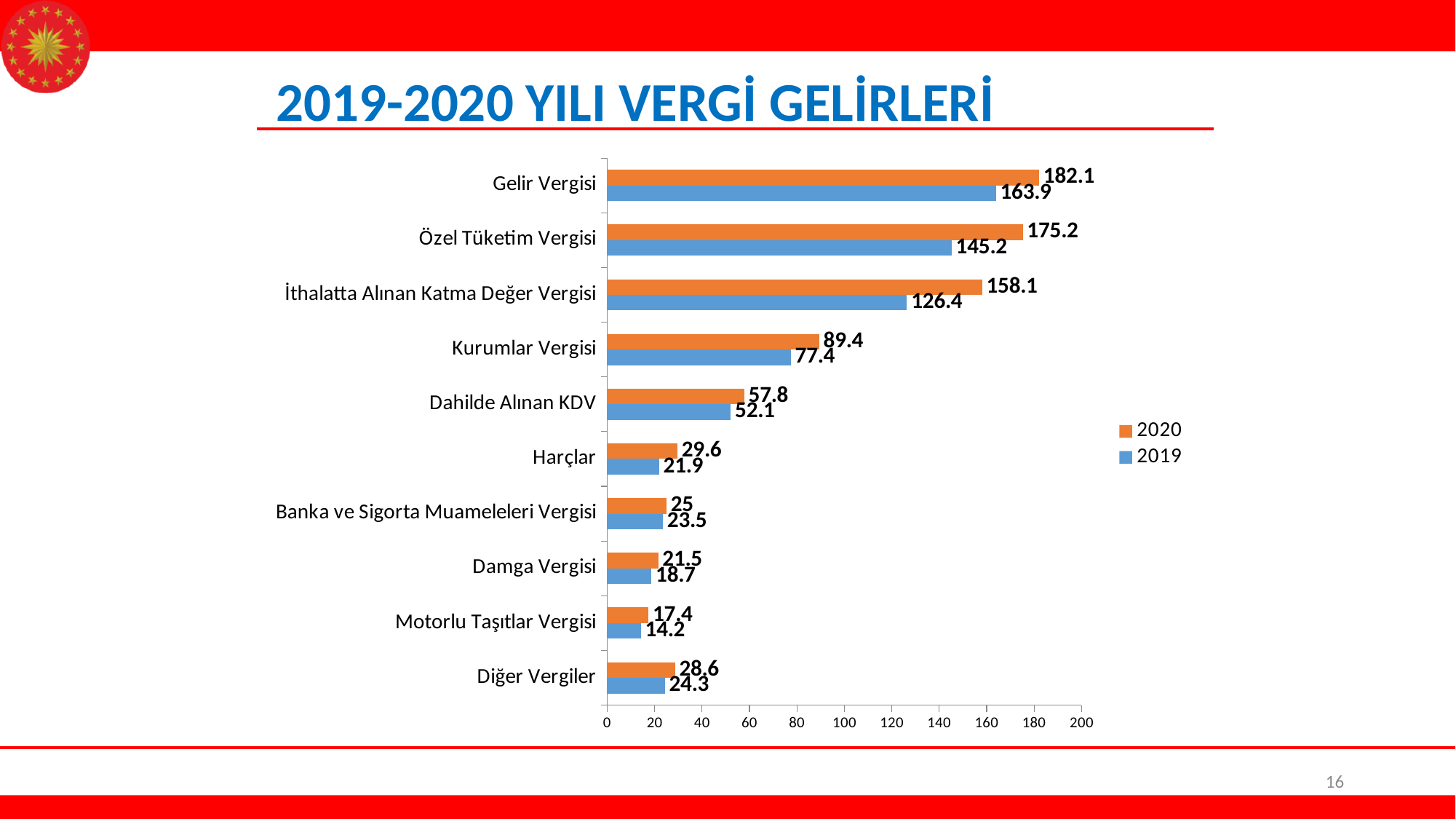
What kind of chart is shown on the slide? Bar chart What is the difference between the 2020 and 2019 values for Özel Tüketim Vergisi? 30 What is the 2020 value for Kurumlar Vergisi? 89.4 How many categories are shown on the chart? 10 What is the 2019 value for Motorlu Taşıtlar Vergisi? 14.2 What is the 2020 value for Gelir Vergisi? 182.1 What is the difference between the 2020 and 2019 values for Gelir Vergisi? 18.2 Which category has the lowest 2019 value? Motorlu Taşıtlar Vergisi Which is larger: the 2020 value for Harçlar or the 2020 value for Diğer Vergiler? Harçlar Which category has the highest 2020 value? Gelir Vergisi What is the 2019 value for Özel Tüketim Vergisi? 145.2 How many series does the legend list? 2